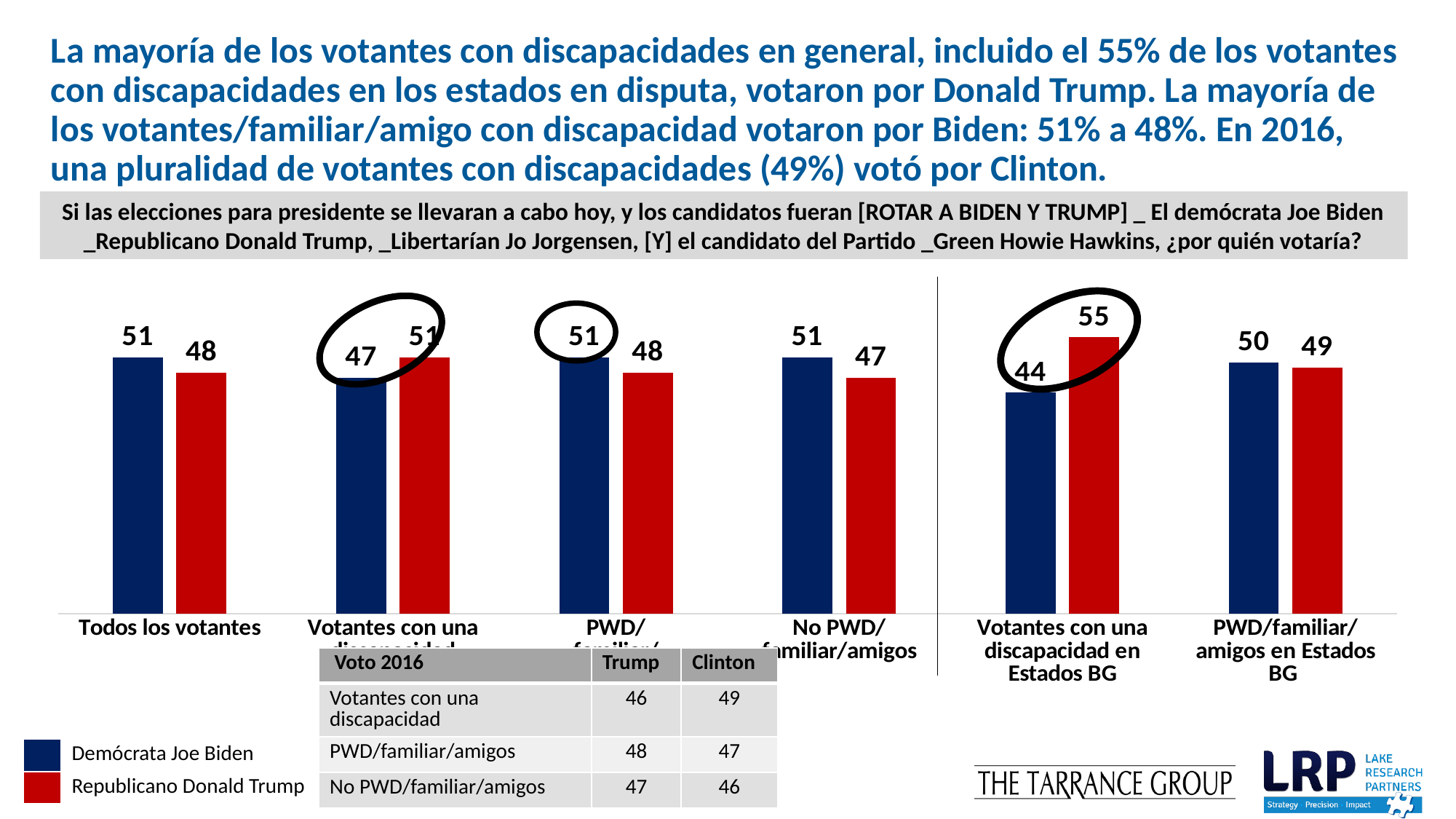
In the 'No PWD/familiar/amigos' category, which is larger: the value for Biden or the value for Trump? Biden What is the value for Republicano Donald Trump in the 'Votantes con una discapacidad en Estados BG' category? 55 Which category has the lowest value for Demócrata Joe Biden? Votantes con una discapacidad en Estados BG What is the value for Demócrata Joe Biden in the 'Todos los votantes' category? 51 Which colour represents Republicano Donald Trump in the chart? red Which category has the highest value for Republicano Donald Trump? Votantes con una discapacidad en Estados BG What kind of chart is shown on the slide? bar chart How many categories are shown along the x axis of the bar chart? 6 What is the difference between the Trump and Biden values in the 'Votantes con una discapacidad en Estados BG' category? 11 What is the value for Republicano Donald Trump in the 'PWD/familiar/amigos en Estados BG' category? 49 How many series does the legend list? 2 What is the value for Demócrata Joe Biden in the 'No PWD/familiar/amigos' category? 51